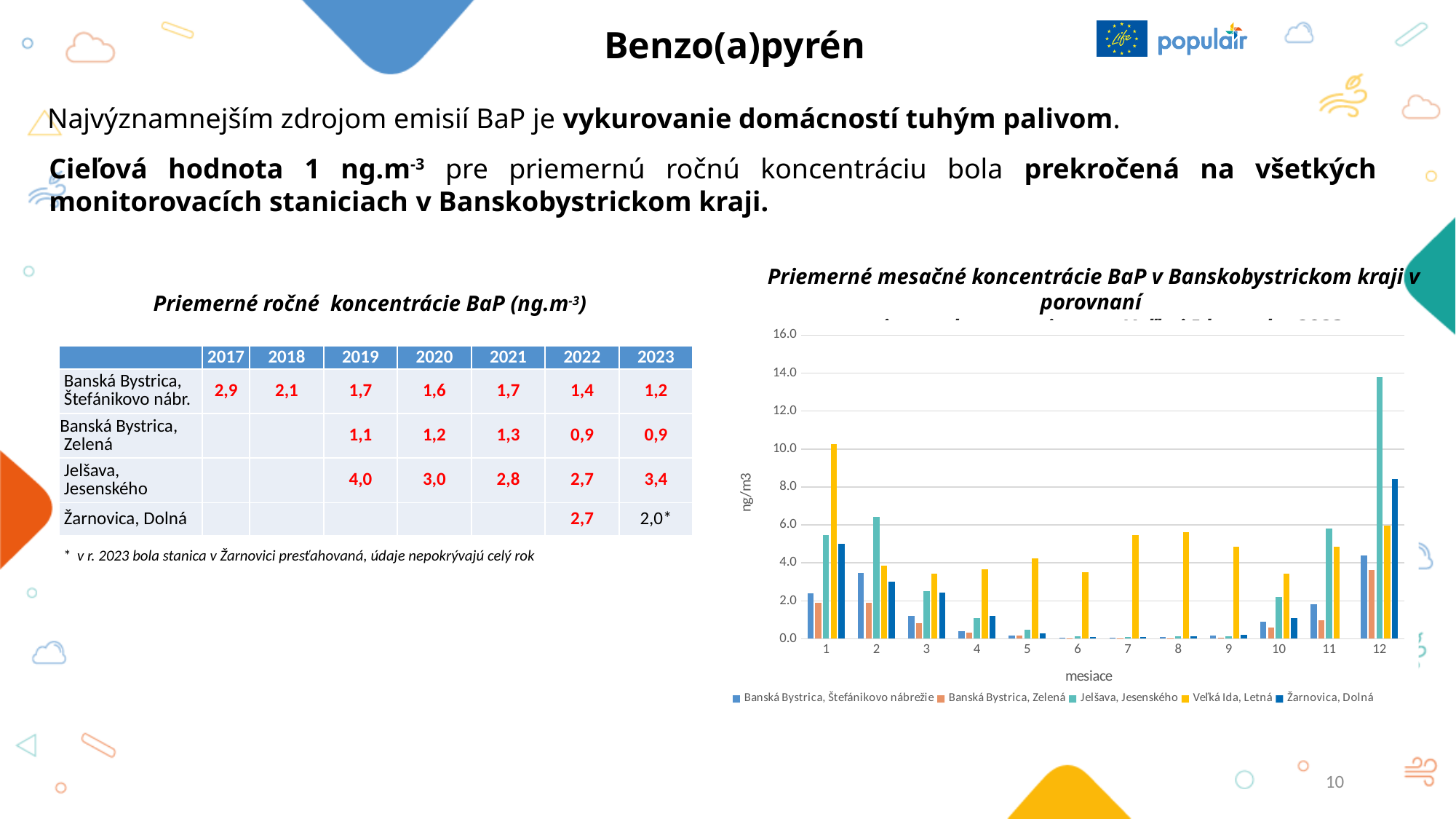
In the monthly BaP concentration chart, in which month does Jelšava, Jesenského reach its highest value? 12 In the monthly BaP concentration chart, is the value for Banská Bystrica, Štefánikovo nábrežie in month 2 greater or less than 4.0? less What kind of chart is shown on the right side of the slide? bar chart How many series does the legend of the monthly BaP concentration chart list? 5 How many months (categories) are shown on the x axis of the monthly BaP concentration chart? 12 In the monthly BaP concentration chart, which is larger in month 1: Veľká Ida, Letná or Žarnovica, Dolná? Veľká Ida, Letná In the monthly BaP concentration chart, is the value for Veľká Ida, Letná in month 1 greater or less than 8.0? greater In the monthly BaP concentration chart, which is larger in month 12: Jelšava, Jesenského or Žarnovica, Dolná? Jelšava, Jesenského What is the label of the y axis on the monthly BaP concentration chart? ng/m3 In the monthly BaP concentration chart, which series has the tallest bar in month 12? Jelšava, Jesenského In the monthly BaP concentration chart, which series has the tallest bar in month 1? Veľká Ida, Letná In the monthly BaP concentration chart, is the value for Jelšava, Jesenského in month 12 greater or less than 12.0? greater